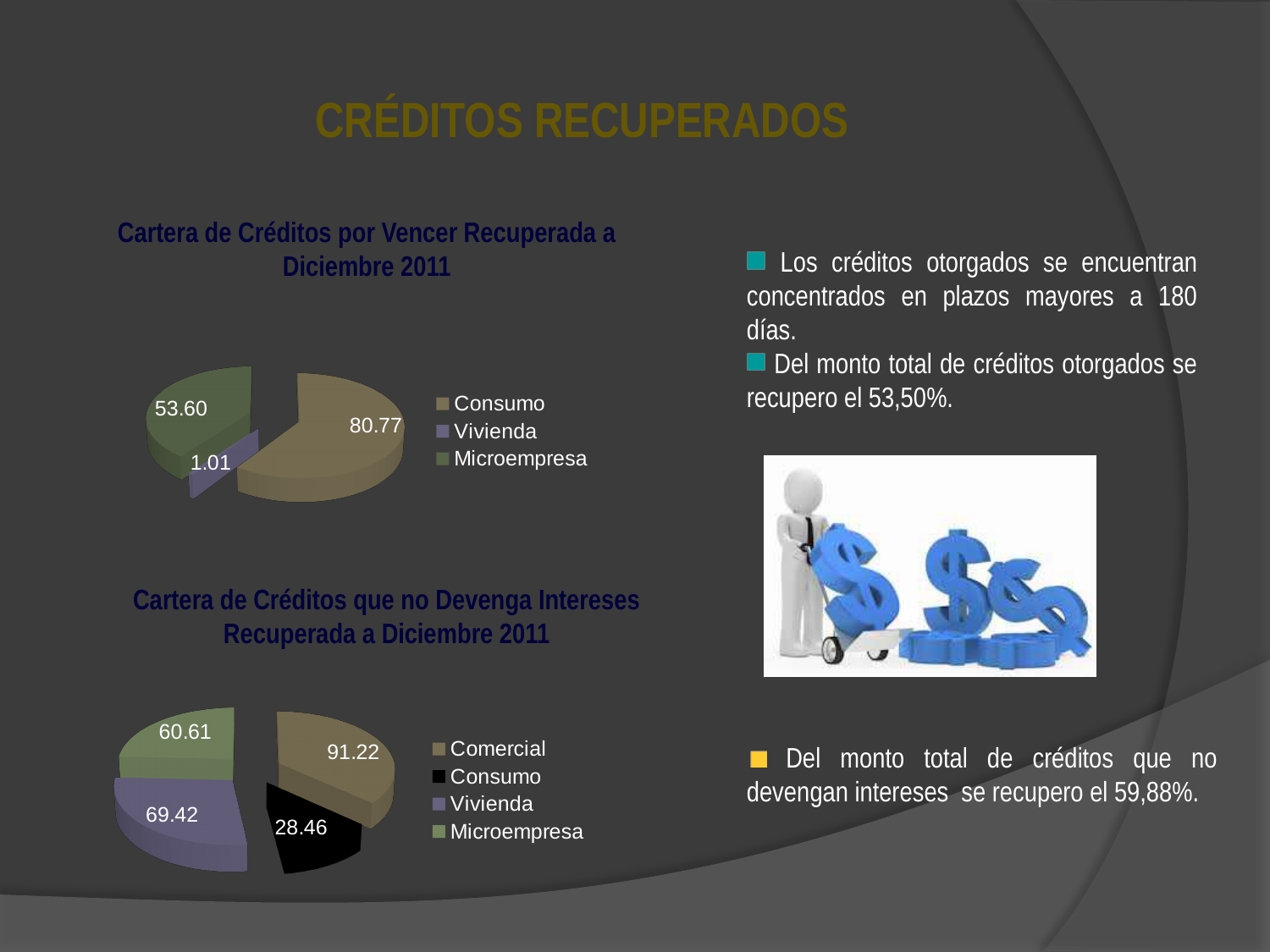
In the chart 'Cartera de Créditos por Vencer Recuperada a Diciembre 2011', which category has the smallest slice? Vivienda In the chart 'Cartera de Créditos que no Devenga Intereses Recuperada a Diciembre 2011', what is the difference between the values for Comercial and Vivienda? 21.80 In the chart 'Cartera de Créditos por Vencer Recuperada a Diciembre 2011', which category has the largest slice? Consumo What type of chart is the bottom chart on the slide? Pie chart In the chart 'Cartera de Créditos que no Devenga Intereses Recuperada a Diciembre 2011', which category has the smallest value? Consumo In the chart 'Cartera de Créditos que no Devenga Intereses Recuperada a Diciembre 2011', what is the value for Comercial? 91.22 In the chart 'Cartera de Créditos por Vencer Recuperada a Diciembre 2011', what is the difference between the values for Consumo and Microempresa? 27.17 In the chart 'Cartera de Créditos por Vencer Recuperada a Diciembre 2011', what is the value for Vivienda? 1.01 In the chart 'Cartera de Créditos por Vencer Recuperada a Diciembre 2011', what is the value for Consumo? 80.77 In the chart 'Cartera de Créditos que no Devenga Intereses Recuperada a Diciembre 2011', which is larger, Vivienda or Microempresa? Vivienda How many categories does the legend of the chart 'Cartera de Créditos por Vencer Recuperada a Diciembre 2011' list? 3 In the chart 'Cartera de Créditos que no Devenga Intereses Recuperada a Diciembre 2011', what is the value for Consumo? 28.46